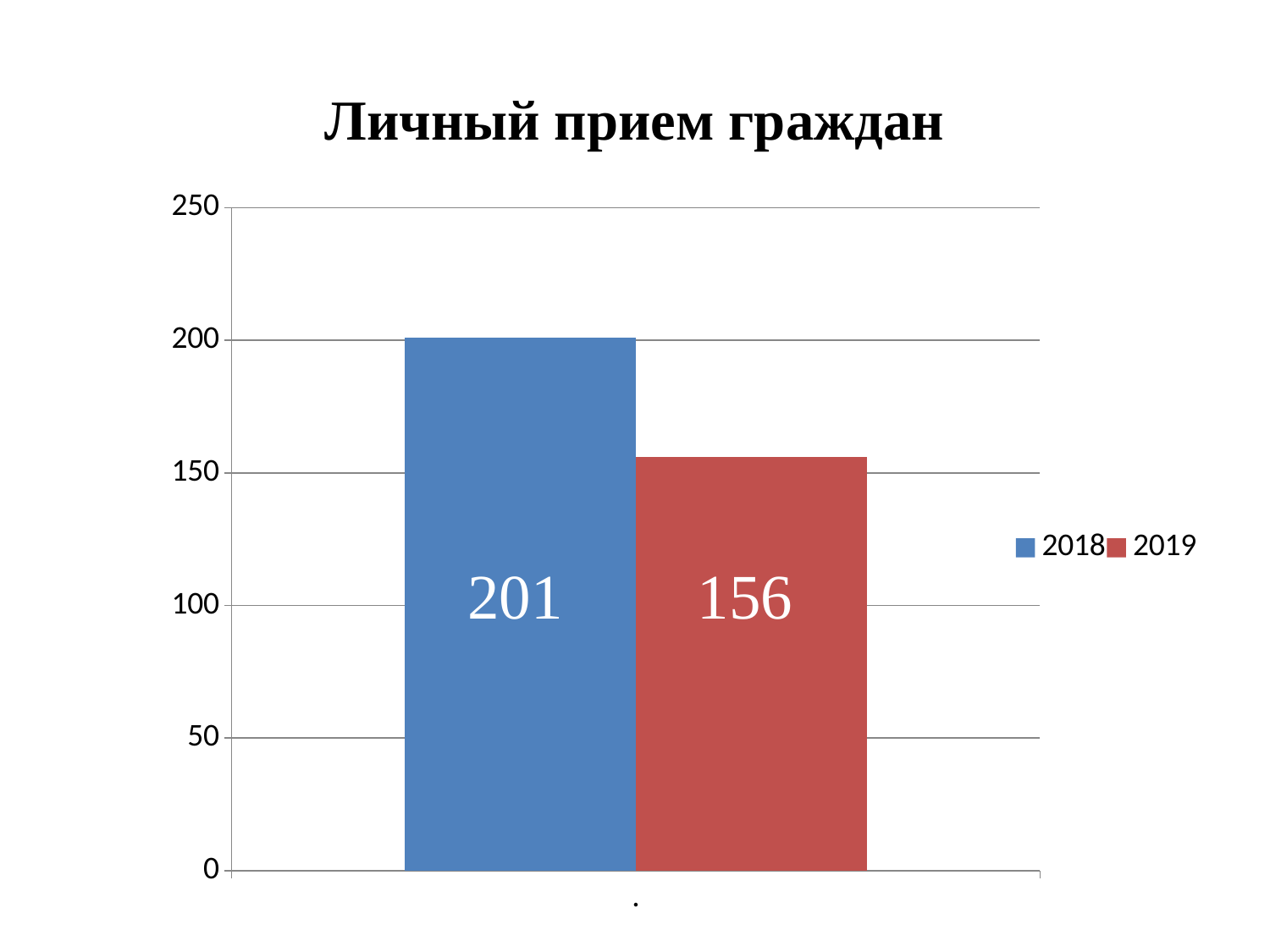
Is the value for 2018 larger or smaller than the value for 2019? larger What is the difference between the values for 2018 and 2019? 45 What kind of chart is shown on the slide? bar chart How many series does the legend list? 2 What is the value for 2019? 156 What is the title of the chart? Личный прием граждан Which year has the higher value? 2018 What colour is the bar for 2019? red Which year has the lower value? 2019 Is the value for 2018 greater or less than 150? greater Is the value for 2019 greater or less than 200? less What is the value for 2018? 201